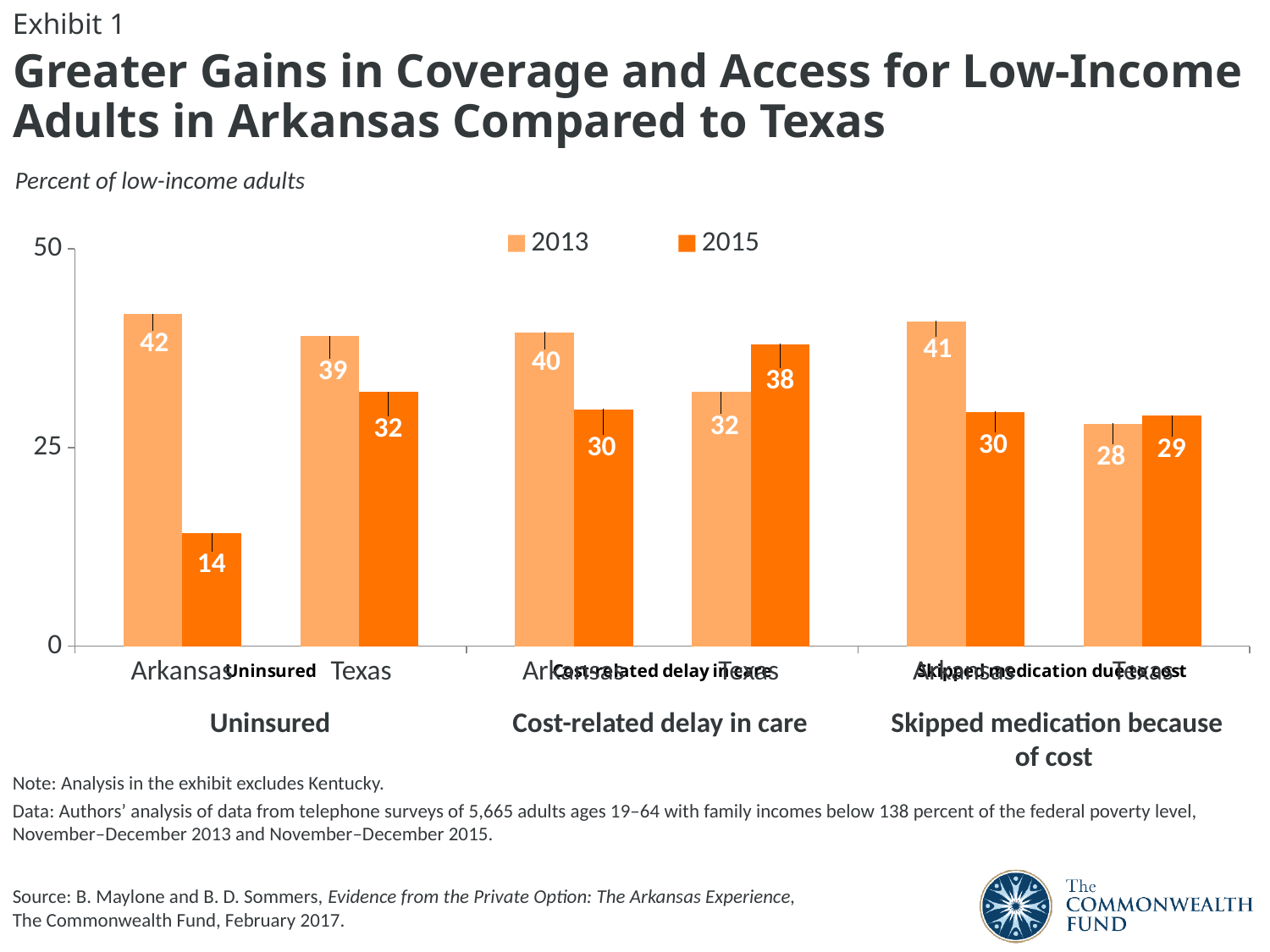
How many series does the legend list? 2 By how many percentage points did the uninsured rate in Arkansas fall from 2013 to 2015? 28 Which bar in the chart has the lowest value? Arkansas uninsured, 2015 (14) What was the uninsured rate for low-income adults in Arkansas in 2015? 14 What is the difference between the 2013 and 2015 values for cost-related delay in care in Texas? 6 What percent of low-income adults in Texas reported a cost-related delay in care in 2015? 38 What percent of low-income adults in Arkansas skipped medication because of cost in 2013? 41 Which bar in the chart has the highest value? Arkansas uninsured, 2013 (42) Which colour represents the 2015 series in the chart? Dark orange In 2015, which state had a higher share of low-income adults reporting a cost-related delay in care, Arkansas or Texas? Texas What type of chart is shown on the slide? Bar chart What was the uninsured rate for low-income adults in Texas in 2013? 39